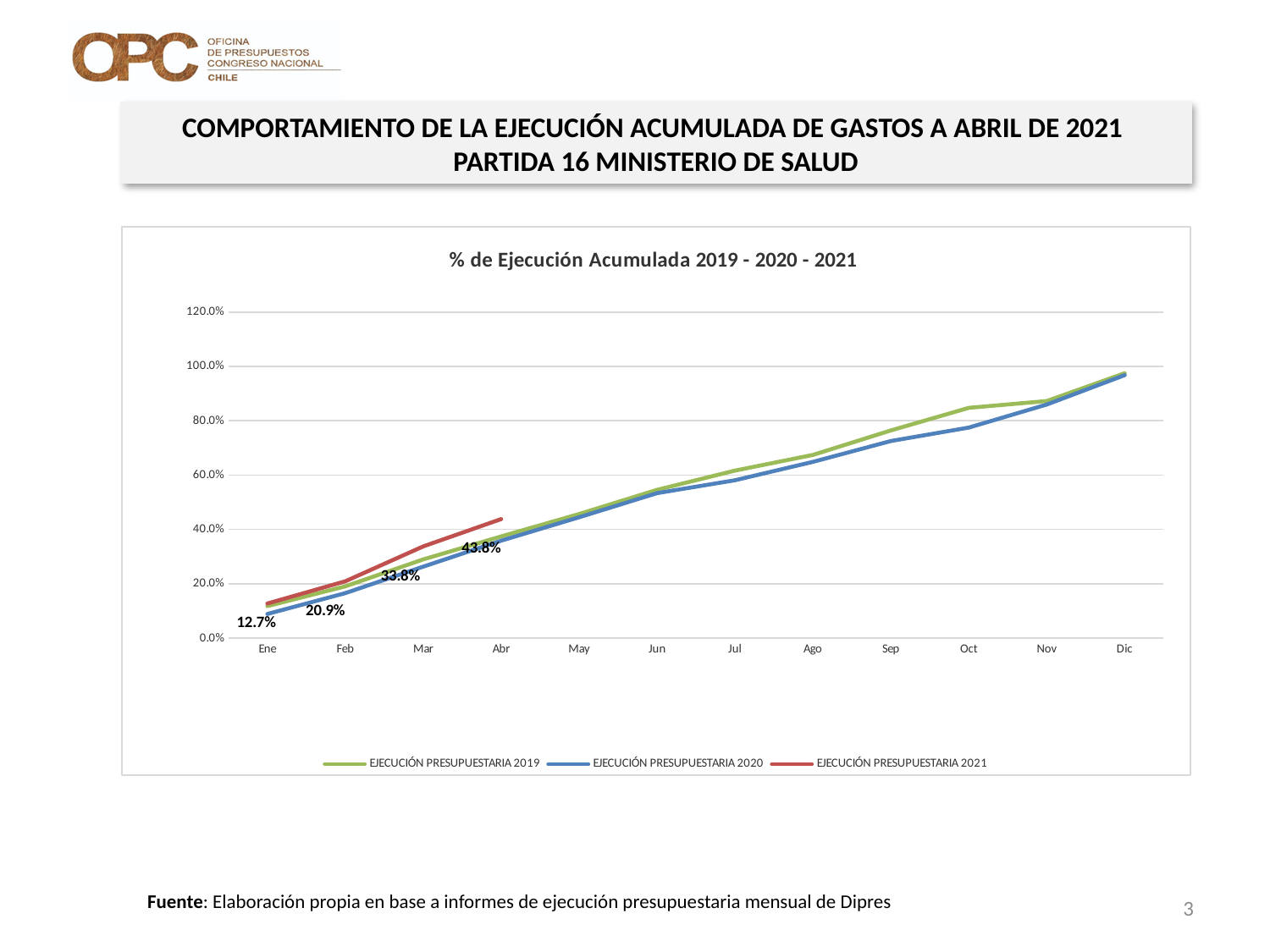
Which month has the highest value for EJECUCIÓN PRESUPUESTARIA 2021? Abr What is the value for EJECUCIÓN PRESUPUESTARIA 2021 in Mar? 33.8% How many series does the legend list? 3 Is the value for EJECUCIÓN PRESUPUESTARIA 2020 in Sep greater or less than 80.0%? less Do the values for EJECUCIÓN PRESUPUESTARIA 2020 rise or fall from Ene to Dic? rise What is the difference between the EJECUCIÓN PRESUPUESTARIA 2021 values for Abr and Mar? 10.0 percentage points How many months are shown along the x axis? 12 What is the title of the chart? % de Ejecución Acumulada 2019 - 2020 - 2021 What is the value for EJECUCIÓN PRESUPUESTARIA 2021 in Feb? 20.9% What kind of chart is shown on the slide? line chart What is the value for EJECUCIÓN PRESUPUESTARIA 2021 in Ene? 12.7% What is the value for EJECUCIÓN PRESUPUESTARIA 2021 in Abr? 43.8%